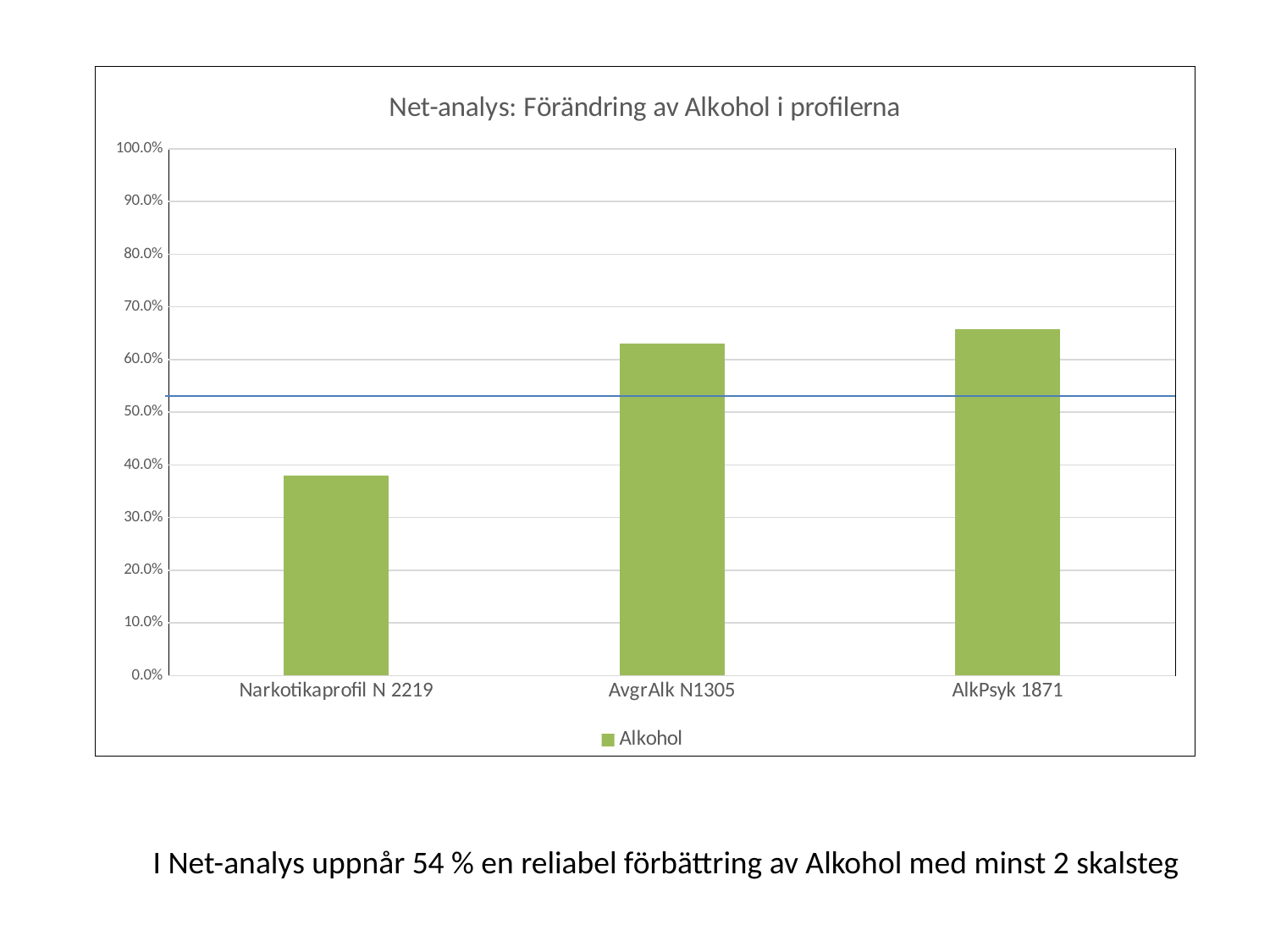
Do the values rise or fall from left to right along the x axis? rise How many categories are shown on the x axis of the chart? 3 Is the value for AlkPsyk 1871 greater or less than 70.0%? less Is the value for AvgrAlk N1305 greater or less than 60.0%? greater What type of chart is shown on the slide? bar chart Is the value for Narkotikaprofil N 2219 greater or less than 40.0%? less How many series does the legend list? 1 Which category has the lowest value? Narkotikaprofil N 2219 What is the title of the chart? Net-analys: Förändring av Alkohol i profilerna Which category has the highest value? AlkPsyk 1871 What series name is shown in the legend? Alkohol Which is larger, the value for Narkotikaprofil N 2219 or the value for AvgrAlk N1305? AvgrAlk N1305